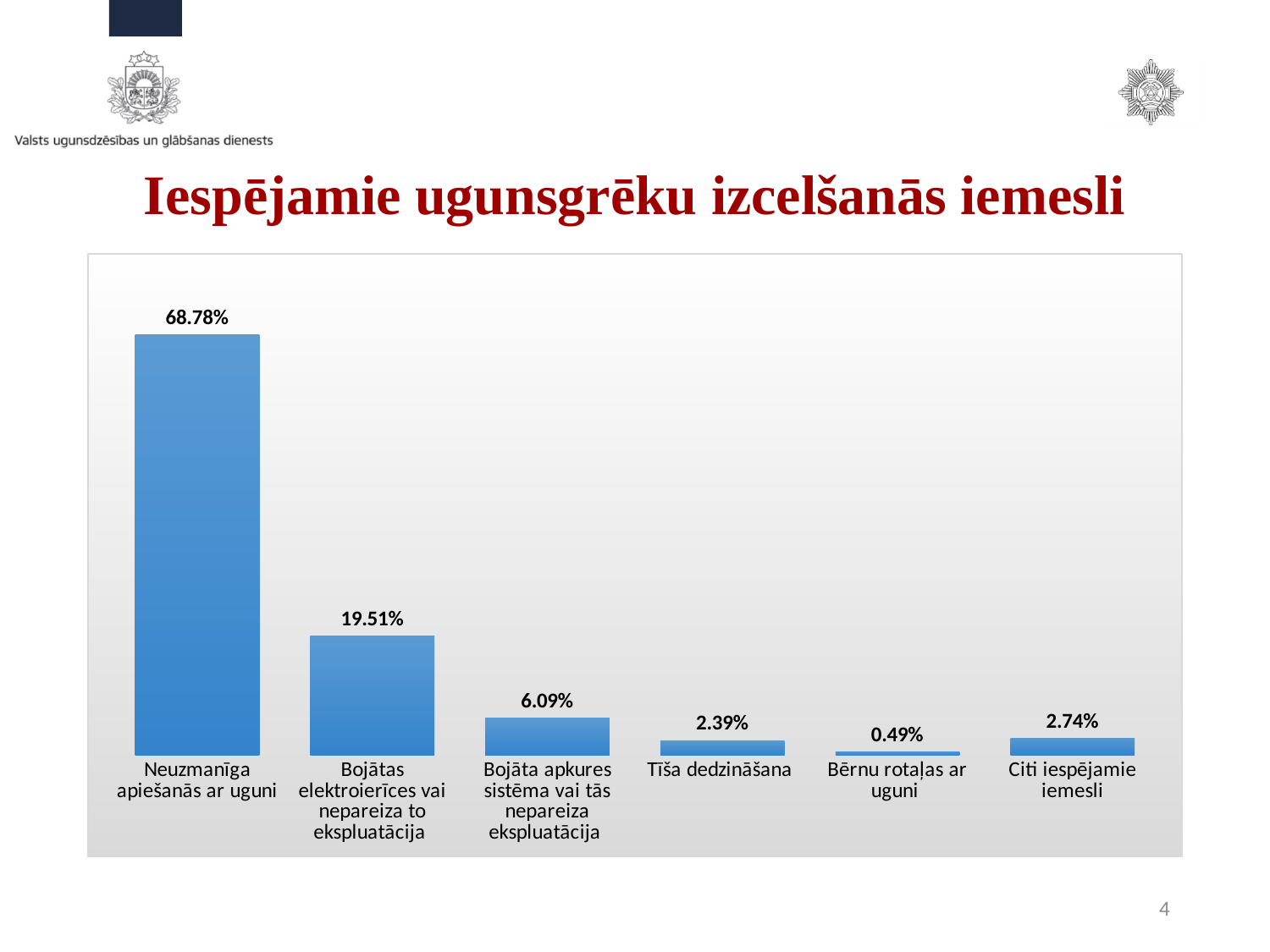
What is the value for Neuzmanīga apiešanās ar uguni? 68.78% How many categories are shown in the chart? 6 Which category has the lowest value? Bērnu rotaļas ar uguni What is the value for Citi iespējamie iemesli? 2.74% Which is larger, the value for Tīša dedzināšana or the value for Citi iespējamie iemesli? Citi iespējamie iemesli What is the value for Bojāta apkures sistēma vai tās nepareiza ekspluatācija? 6.09% What is the value for Bojātas elektroierīces vai nepareiza to ekspluatācija? 19.51% Which category has the highest value? Neuzmanīga apiešanās ar uguni What is the difference between the values for Neuzmanīga apiešanās ar uguni and Bojātas elektroierīces vai nepareiza to ekspluatācija? 49.27% What is the value for Tīša dedzināšana? 2.39% What kind of chart is shown on the slide? Bar chart What is the value for Bērnu rotaļas ar uguni? 0.49%